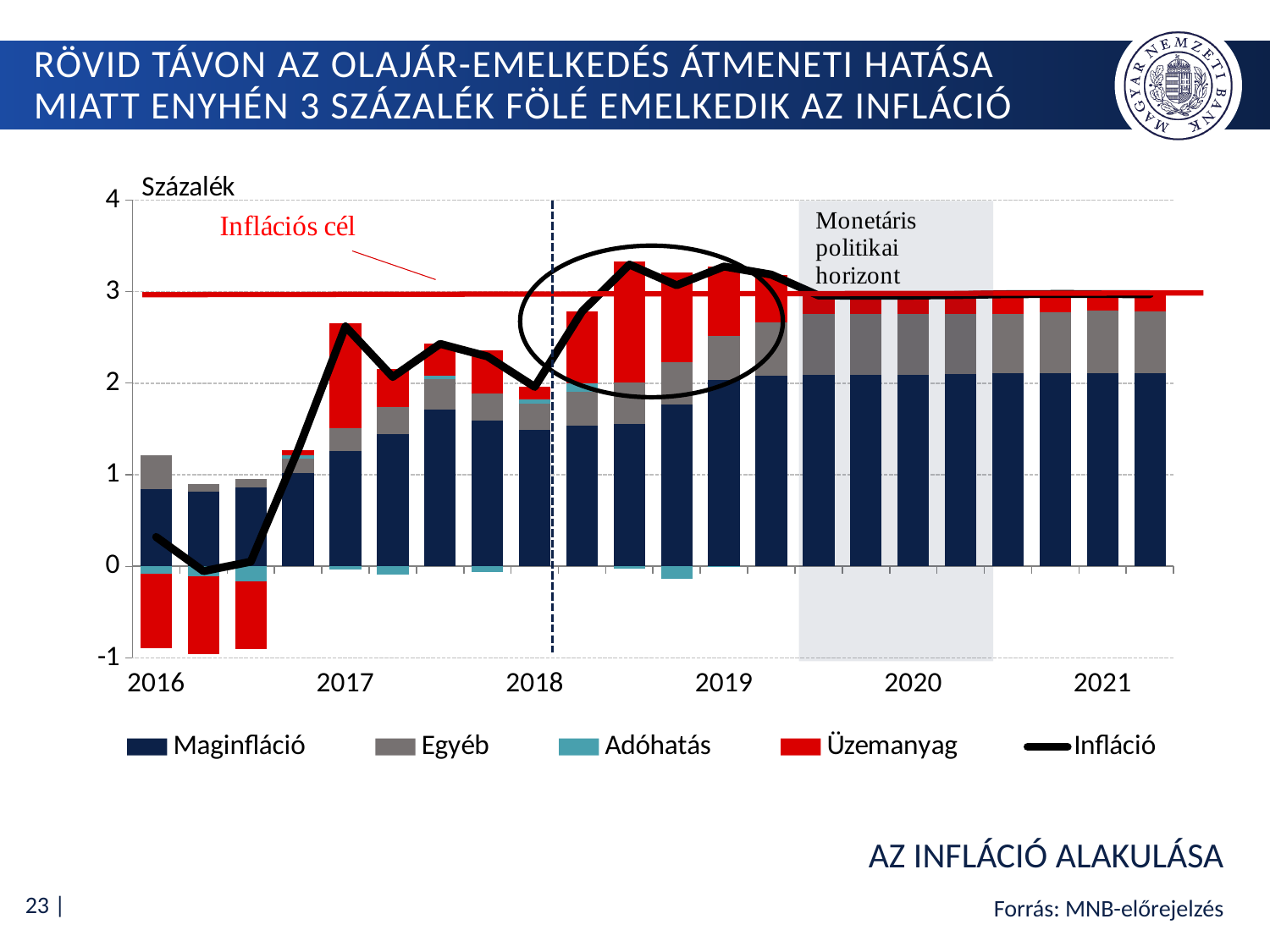
At what level is the red Inflációs cél line drawn on the y axis? 3 How many year labels are shown on the x axis? 6 Is the peak of the Infláció line in the second half of 2018 greater or less than 3? greater Is the Üzemanyag contribution in the first bar of 2016 greater or less than 0? less Is the Infláció line value at the start of 2016 greater or less than 1? less Does the Infláció line rise or fall between the start of 2016 and the start of 2017? rise What kind of chart is shown on the slide? A stacked bar chart with a line Which series is drawn as a black line rather than bars? Infláció How many series does the legend list? 5 What is the chart's title shown at the bottom right of the slide? AZ INFLÁCIÓ ALAKULÁSA